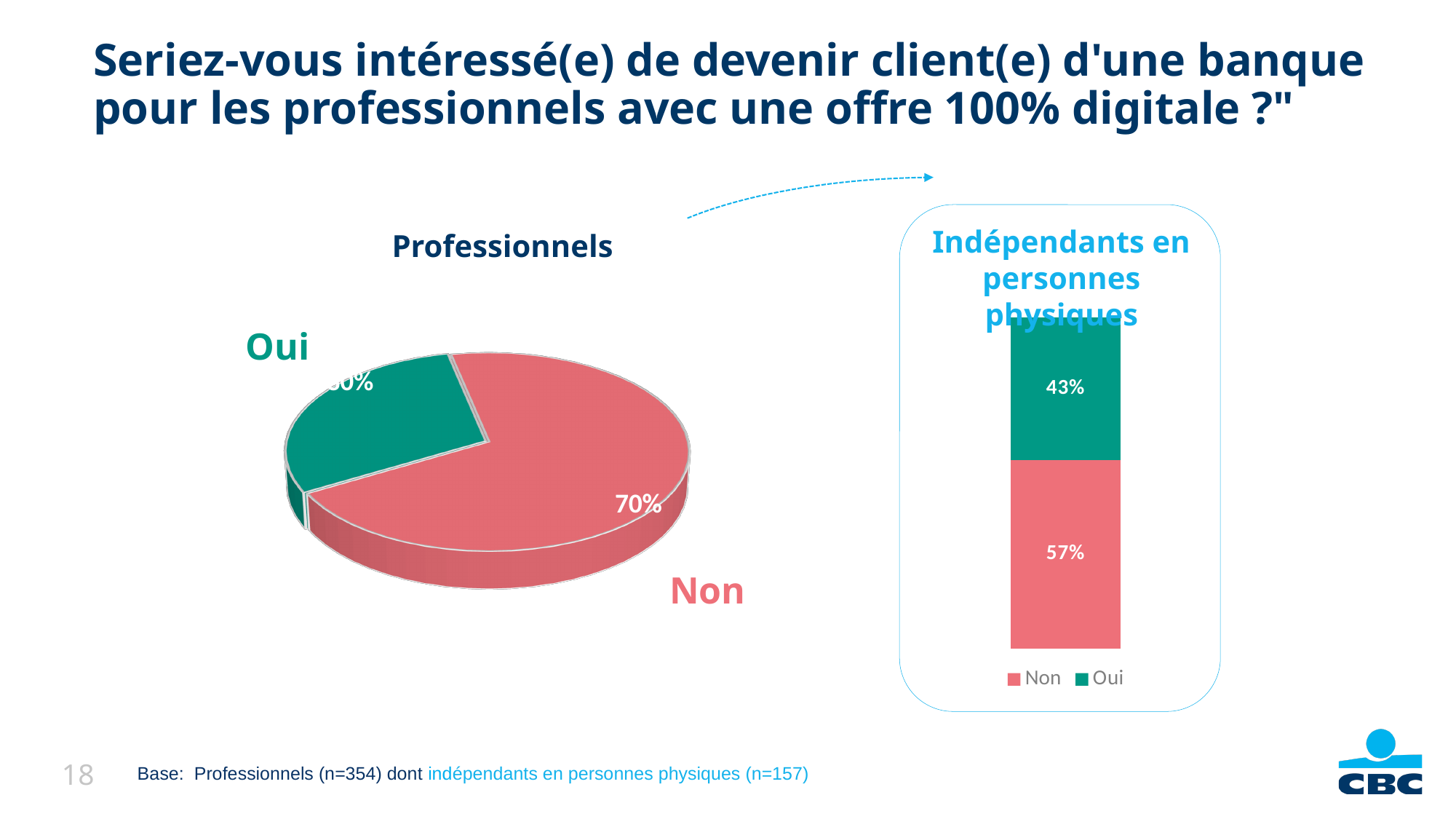
In the 'Professionnels' pie chart, which slice is larger, Oui or Non? Non In the 'Indépendants en personnes physiques' chart, what is the value for Oui? 43% How many series does the legend of the 'Indépendants en personnes physiques' chart list? 2 In the 'Indépendants en personnes physiques' chart, what is the value for Non? 57% In the 'Indépendants en personnes physiques' chart, which is larger, Non or Oui? Non In the 'Professionnels' pie chart, what percentage is shown for Non? 70% What kind of chart is the 'Professionnels' chart on the left? Pie chart How many slices does the 'Professionnels' pie chart have? 2 What kind of chart is the 'Indépendants en personnes physiques' chart on the right? Bar chart In the 'Indépendants en personnes physiques' chart, what colour represents Oui in the legend? Green In the 'Indépendants en personnes physiques' chart, what is the total of the stacked bar? 100% In the 'Indépendants en personnes physiques' chart, what is the difference between Non and Oui? 14%